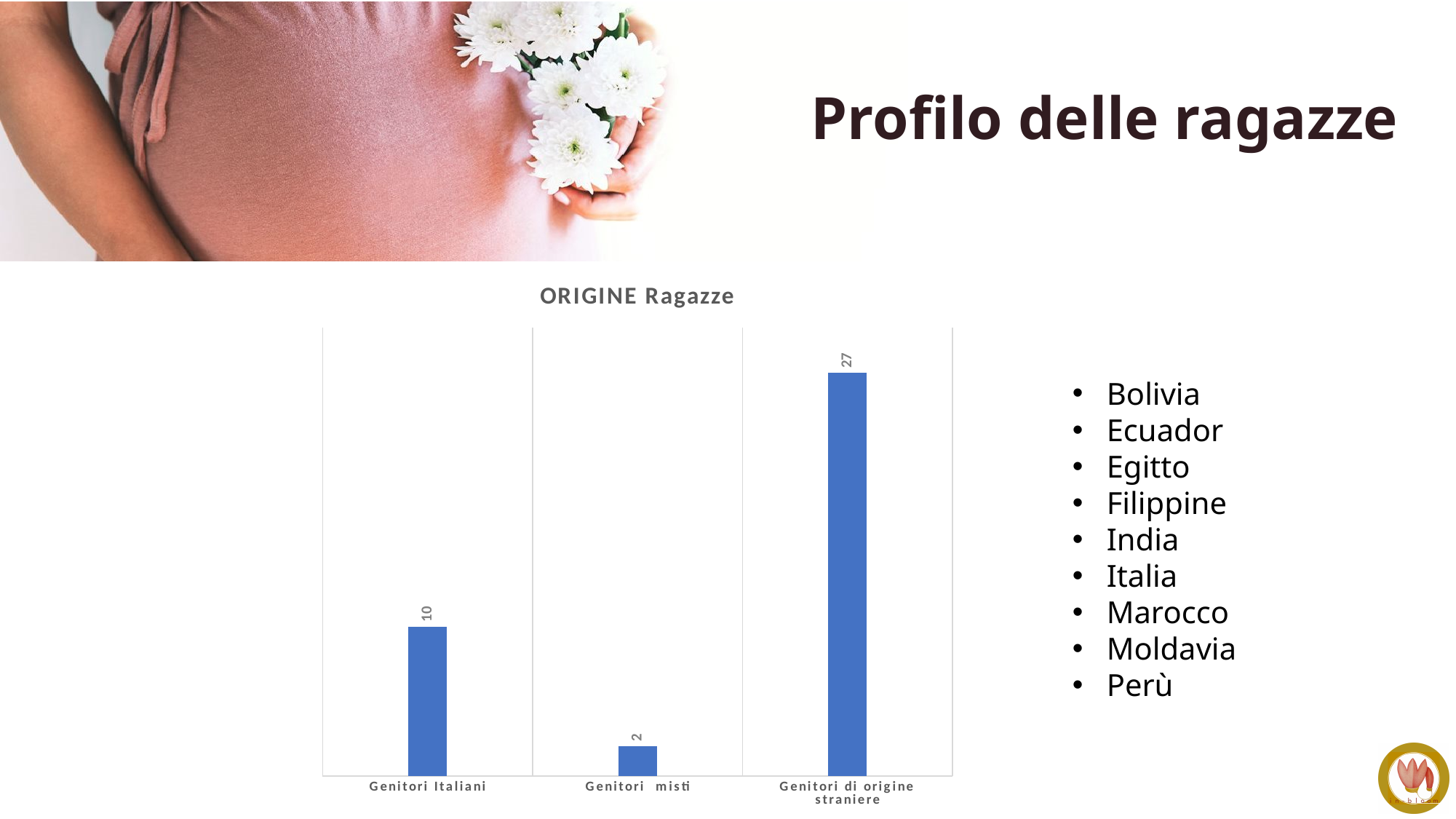
What kind of chart is the ORIGINE Ragazze chart? Bar chart Which category has the highest value in the ORIGINE Ragazze chart? Genitori di origine straniere What is the value for Genitori di origine straniere in the ORIGINE Ragazze chart? 27 What is the difference between the values for Genitori Italiani and Genitori misti? 8 How many categories are shown in the ORIGINE Ragazze chart? 3 Which is larger, the value for Genitori Italiani or the value for Genitori misti? Genitori Italiani What is the value for Genitori misti in the ORIGINE Ragazze chart? 2 What is the total of all three values in the ORIGINE Ragazze chart? 39 What is the difference between the values for Genitori di origine straniere and Genitori Italiani? 17 What is the value for Genitori Italiani in the ORIGINE Ragazze chart? 10 What is the title of the chart on the slide? ORIGINE Ragazze Which category has the lowest value in the ORIGINE Ragazze chart? Genitori misti